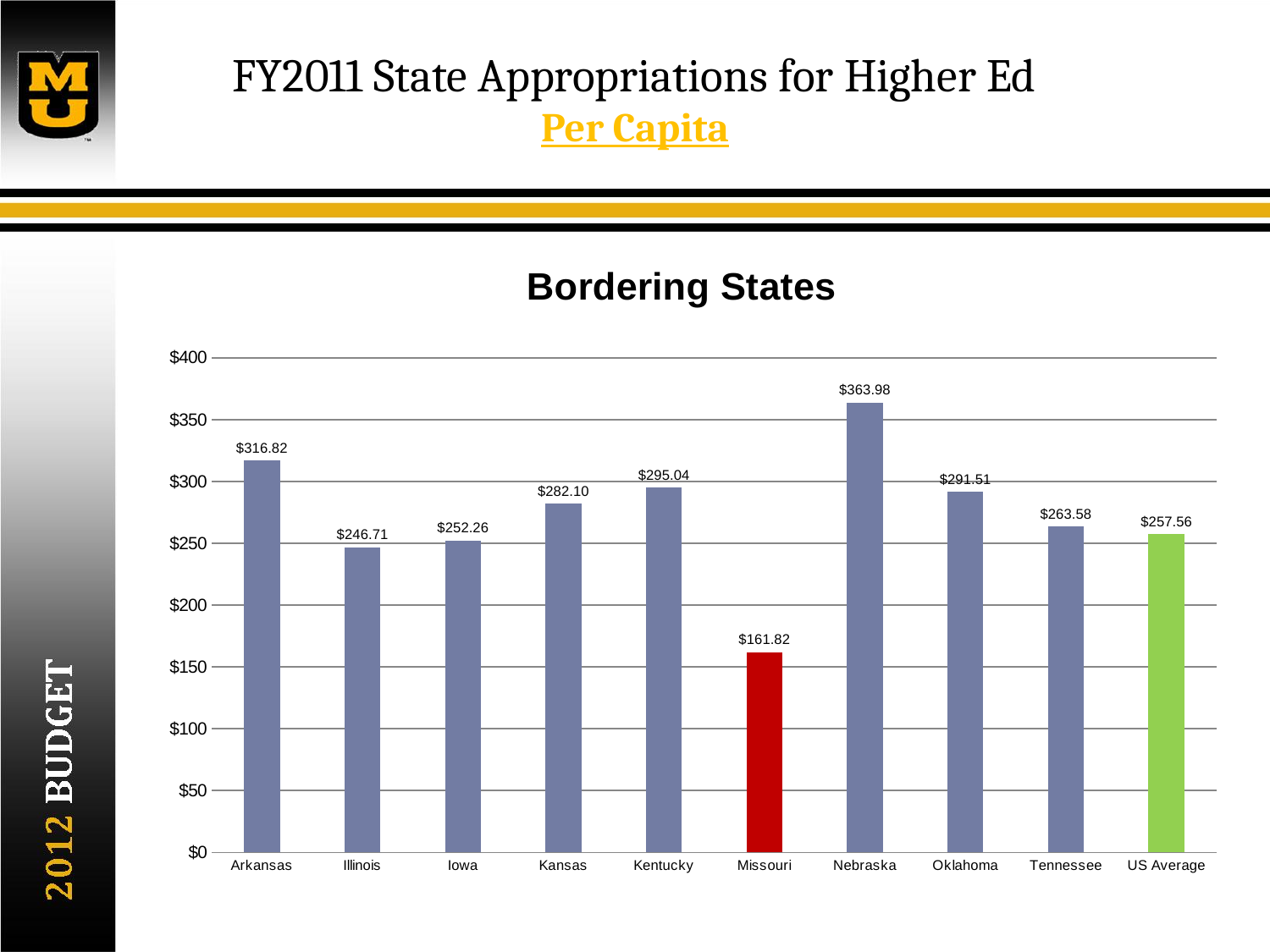
How much higher is the US Average than Missouri's value? $95.74 Is the value for Tennessee greater or less than $250? greater What is the per capita value for Missouri? $161.82 Which state has the lowest per capita appropriation? Missouri How many bars are shown in the chart? 10 What type of chart is shown on the slide? Bar chart Which state has the highest per capita appropriation? Nebraska Which is larger, the value for Kentucky or the value for Oklahoma? Kentucky What is the difference between Nebraska's and Missouri's values? $202.16 What is the per capita value for Kansas? $282.10 What is the value shown for US Average? $257.56 What is the per capita value for Nebraska? $363.98